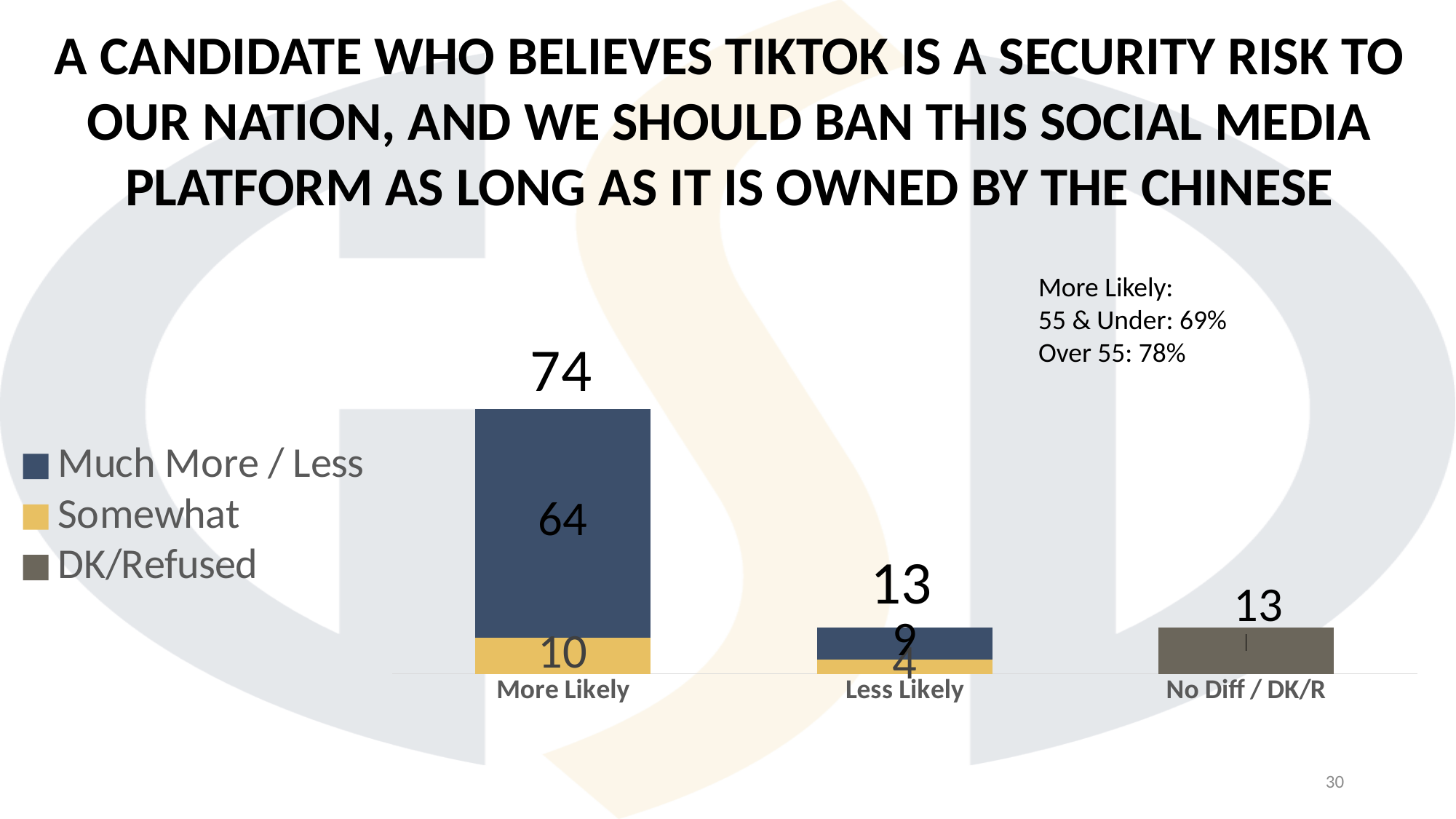
How many series does the legend list? 3 What is the total value shown above the More Likely bar? 74 What kind of chart is shown on the slide? Stacked bar chart What is the Much More / Less value for the More Likely category? 64 What is the Much More / Less value for the Less Likely category? 9 What is the Somewhat value for the More Likely category? 10 What is the difference between the More Likely total and the Less Likely total? 61 How many categories are shown on the x axis? 3 Which category has the highest total? More Likely Which is larger: the Much More / Less value for More Likely or for Less Likely? More Likely What is the value for the No Diff / DK/R category? 13 What is the Somewhat value for the Less Likely category? 4